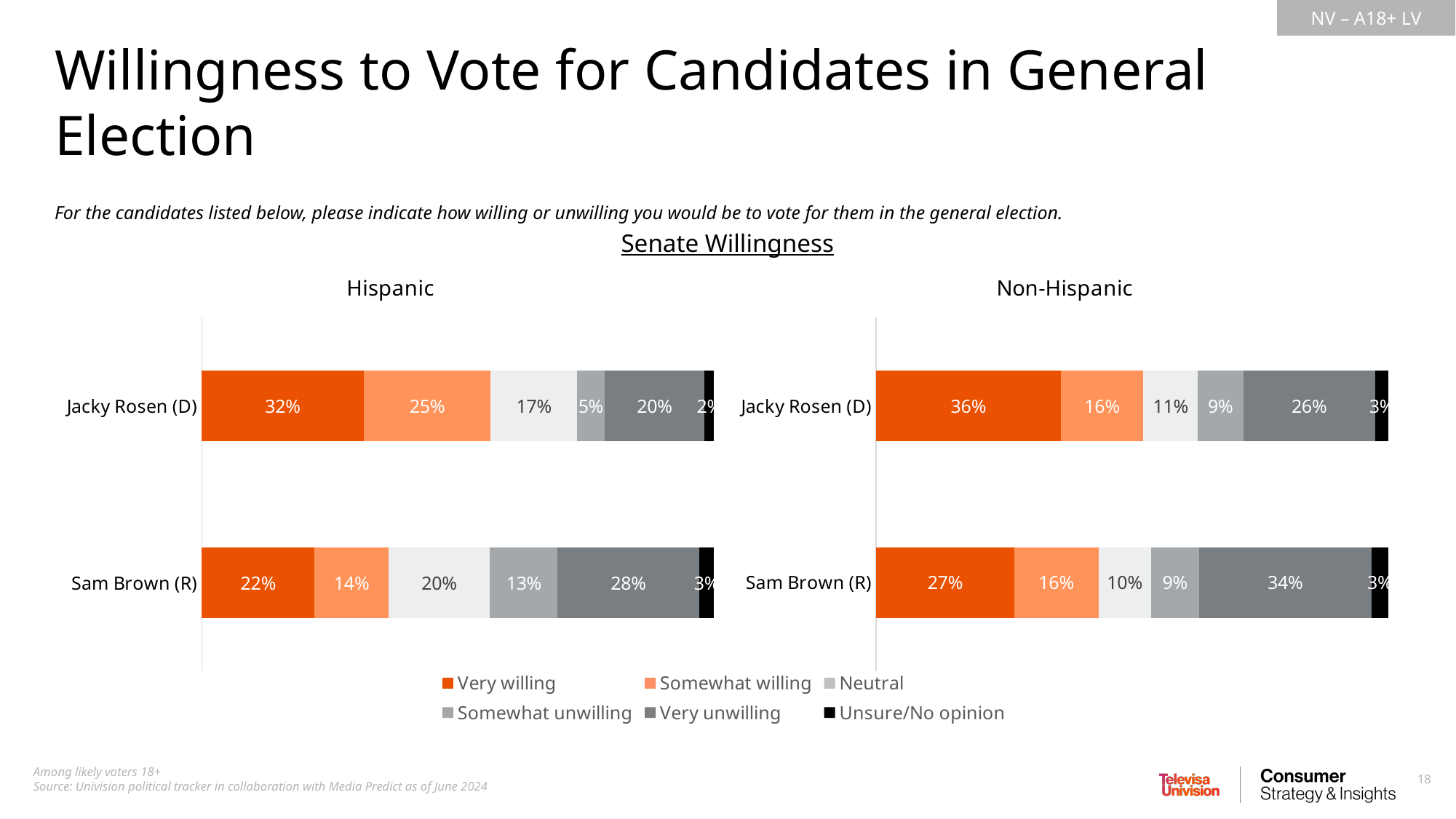
How many series does the legend list? 6 In the Hispanic chart, which candidate has the higher very willing percentage? Jacky Rosen (D) In the Hispanic chart, what percentage of respondents are very willing to vote for Jacky Rosen (D)? 32% Which legend entry is shown in black? Unsure/No opinion In the Hispanic chart, what is the combined very willing and somewhat willing percentage for Jacky Rosen (D)? 57% In the Non-Hispanic chart, what percentage of respondents are very unwilling to vote for Sam Brown (R)? 34% What type of chart is used for the Hispanic data? Stacked bar chart In the Non-Hispanic chart, what is the difference between the very willing percentages for Jacky Rosen (D) and Sam Brown (R)? 9% In the Hispanic chart, what percentage of respondents are neutral about voting for Sam Brown (R)? 20% In the Hispanic chart, what is the difference between the very unwilling percentages for Sam Brown (R) and Jacky Rosen (D)? 8% In the Non-Hispanic chart, what percentage of respondents are somewhat willing to vote for Jacky Rosen (D)? 16% How many candidates are shown in the Non-Hispanic chart? 2